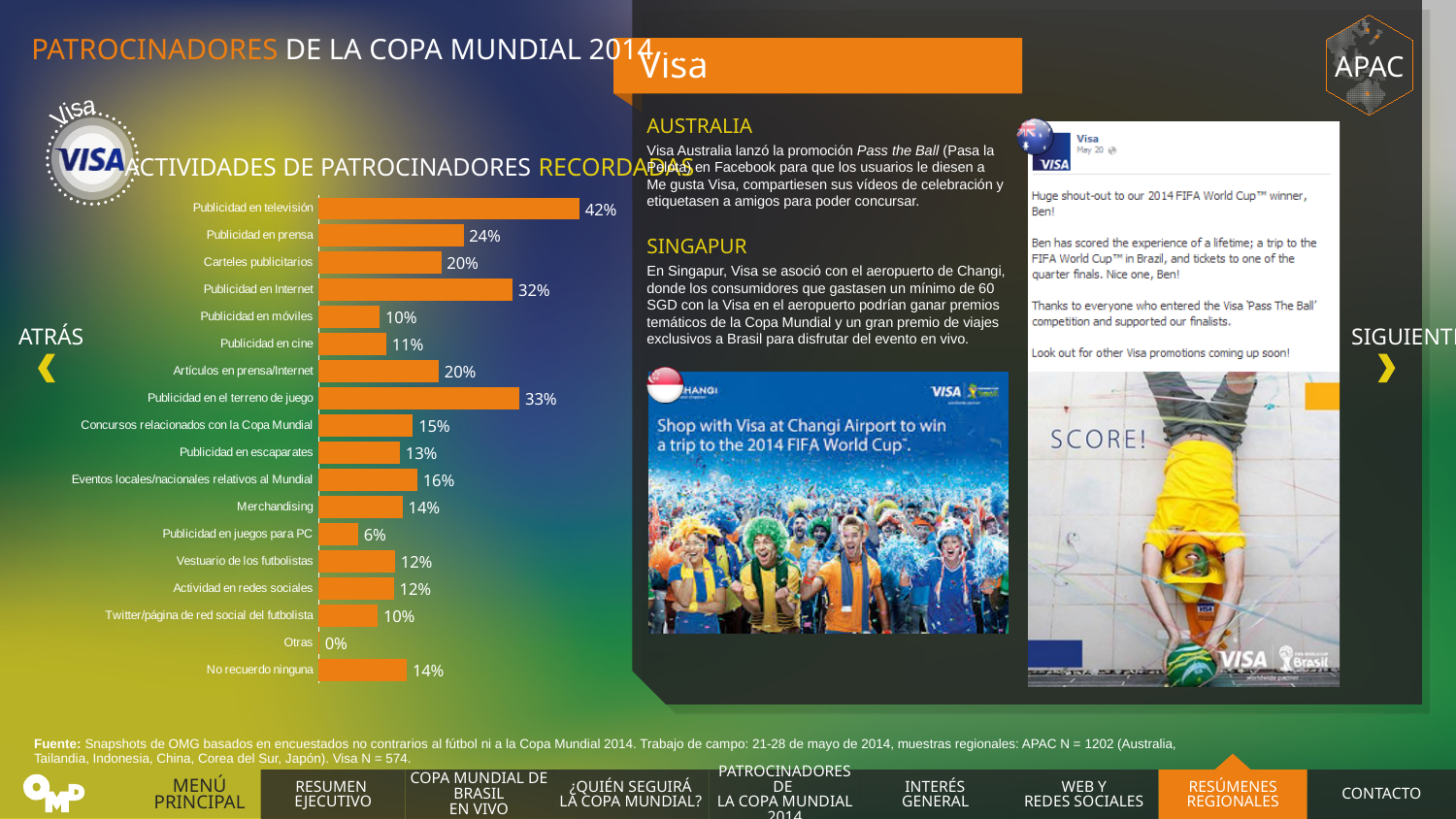
Which is larger, Eventos locales/nacionales relativos al Mundial or Publicidad en escaparates? Eventos locales/nacionales relativos al Mundial What kind of chart is shown on the slide? Bar chart What is the difference between Publicidad en prensa and Carteles publicitarios? 4% What is the value for Publicidad en juegos para PC? 6% What is the value for No recuerdo ninguna? 14% Which category has the lowest value? Otras Which category has the highest value? Publicidad en televisión What is the difference between Publicidad en televisión and Publicidad en Internet? 10% Which is larger, Publicidad en el terreno de juego or Publicidad en Internet? Publicidad en el terreno de juego How many categories are shown in the bar chart? 18 What is the value for Publicidad en televisión? 42% What is the value for Publicidad en el terreno de juego? 33%